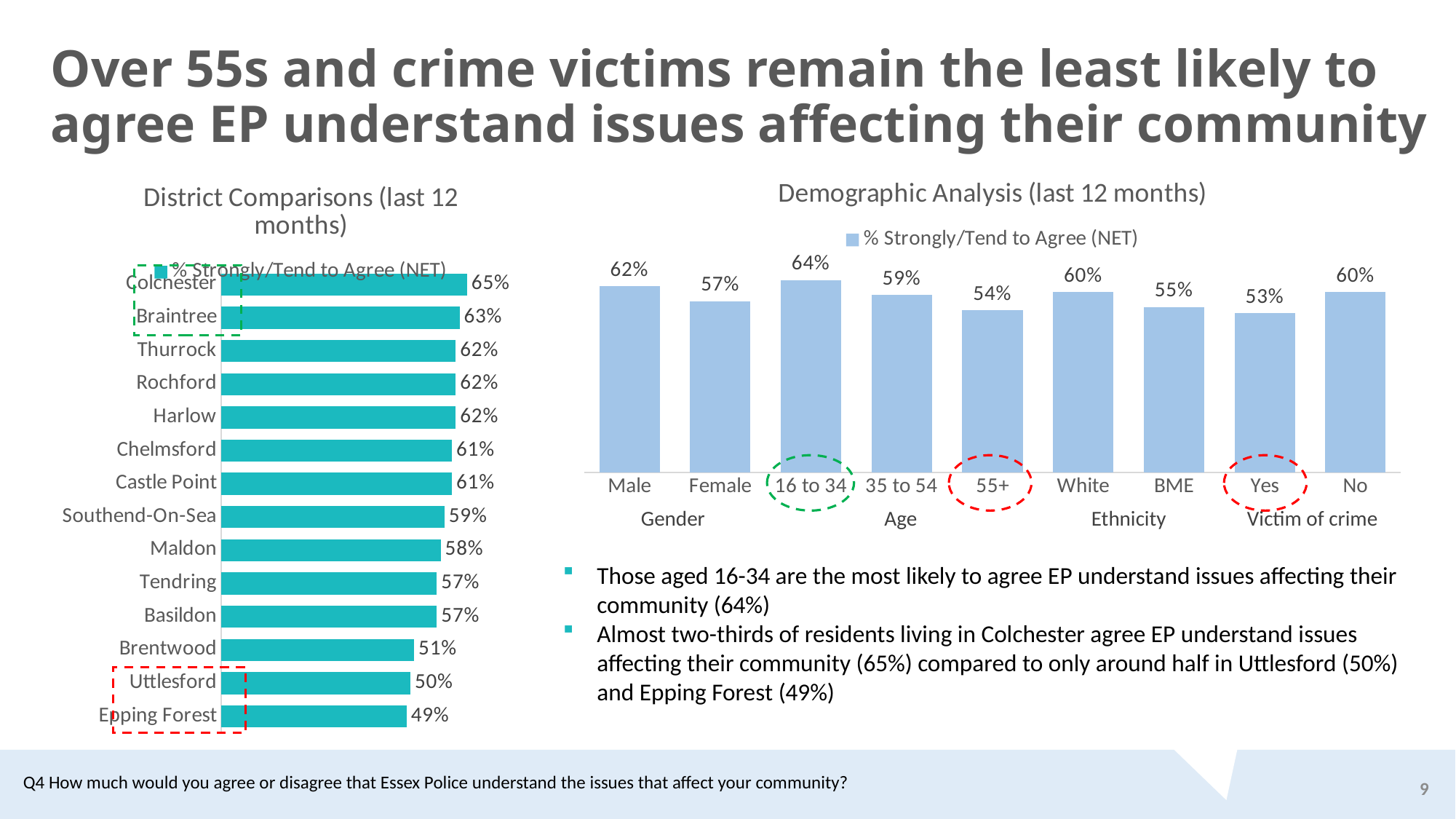
In the District Comparisons chart, how many districts are shown? 14 In the District Comparisons chart, which district has the highest value? Colchester In the Demographic Analysis chart, what is the value for 16 to 34? 64% In the District Comparisons chart, what is the value for Colchester? 65% In the District Comparisons chart, what is the difference between Colchester and Epping Forest? 16 percentage points In the Demographic Analysis chart, how many bars are plotted? 9 In the Demographic Analysis chart, which category has the lowest value? Yes What type of chart is the Demographic Analysis chart? Bar chart In the Demographic Analysis chart, what is the difference between White and BME? 5 percentage points In the District Comparisons chart, what is the value for Brentwood? 51% In the Demographic Analysis chart, which is larger, Male or Female? Male In the District Comparisons chart, which district has the lowest value? Epping Forest